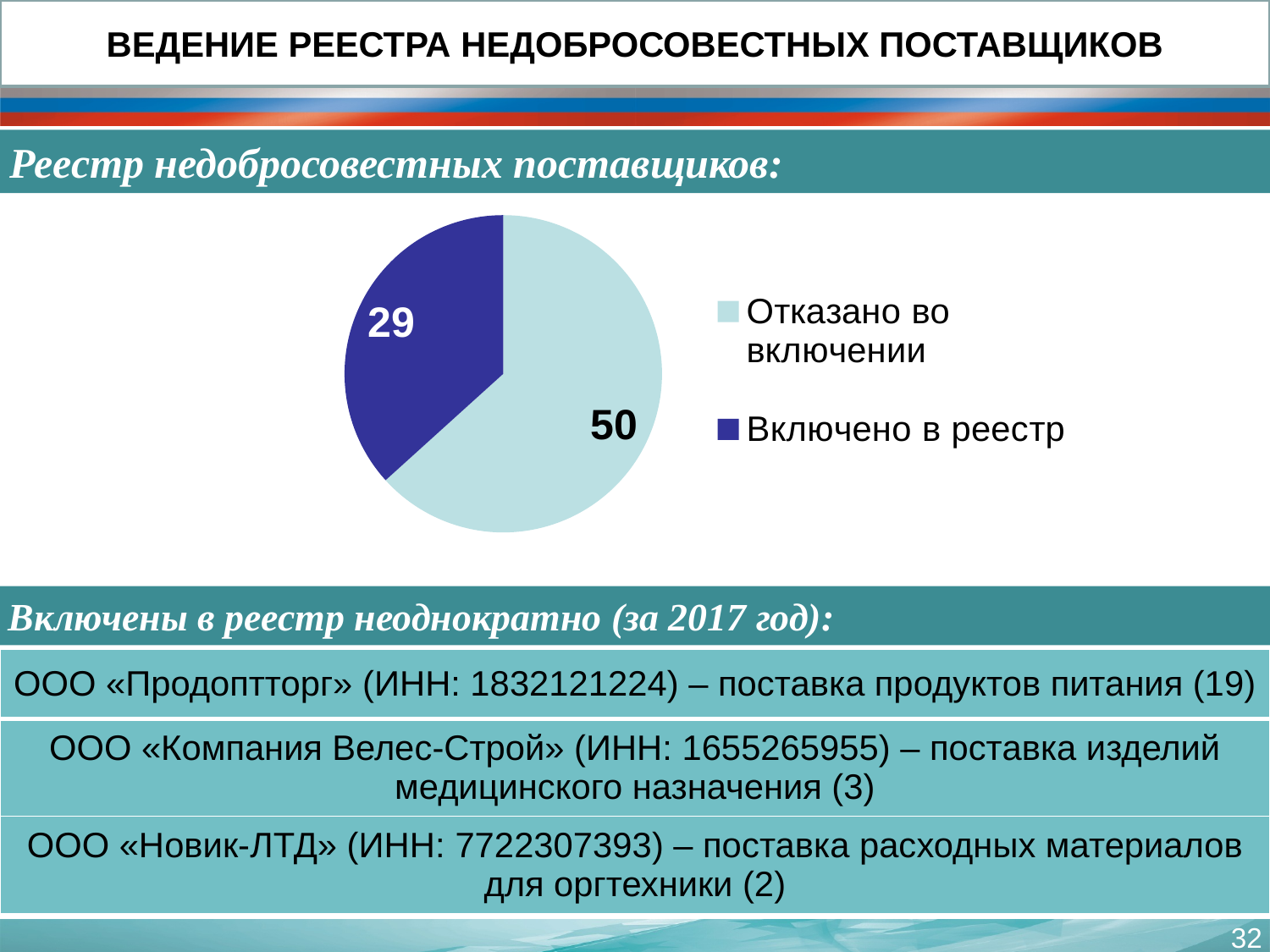
What is the value for "Отказано во включении" in the pie chart? 50 How many slices does the pie chart have? 2 Which category has the largest slice in the pie chart? Отказано во включении What is the difference between the values for "Отказано во включении" and "Включено в реестр"? 21 What type of chart is shown on the slide? pie chart What colour is the slice for "Включено в реестр" in the pie chart? dark blue Which category has the smallest slice in the pie chart? Включено в реестр Which is larger: the value for "Отказано во включении" or for "Включено в реестр"? Отказано во включении What is the total of the two values shown in the pie chart? 79 How many entries does the legend of the pie chart list? 2 What is the heading above the pie chart? Реестр недобросовестных поставщиков: What is the value for "Включено в реестр" in the pie chart? 29